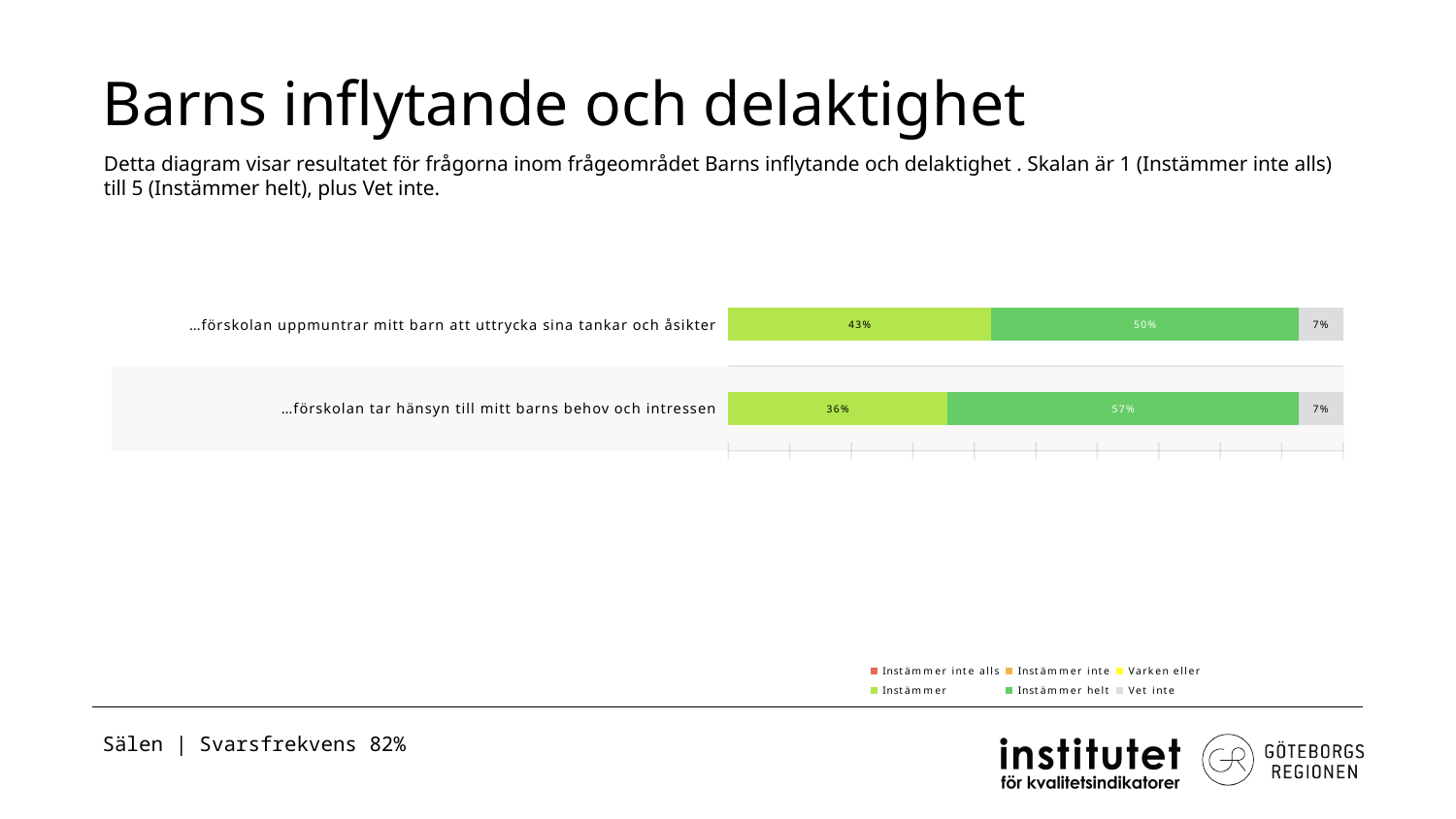
Which statement has the higher 'Instämmer helt' share? …förskolan tar hänsyn till mitt barns behov och intressen What is the 'Instämmer' value for '…förskolan uppmuntrar mitt barn att uttrycka sina tankar och åsikter'? 43% Is the 'Instämmer' value larger for '…förskolan uppmuntrar mitt barn att uttrycka sina tankar och åsikter' or for '…förskolan tar hänsyn till mitt barns behov och intressen'? …förskolan uppmuntrar mitt barn att uttrycka sina tankar och åsikter What kind of chart is shown on the slide? Stacked bar chart Which legend entry is shown in grey? Vet inte What is the difference between the 'Instämmer' values of the two statements? 7% What is the 'Instämmer helt' value for '…förskolan tar hänsyn till mitt barns behov och intressen'? 57% What is the 'Instämmer helt' value for '…förskolan uppmuntrar mitt barn att uttrycka sina tankar och åsikter'? 50% How many categories (statements) are plotted in the chart? 2 What is the 'Vet inte' value for '…förskolan tar hänsyn till mitt barns behov och intressen'? 7% How many series does the legend list? 6 What is the 'Instämmer' value for '…förskolan tar hänsyn till mitt barns behov och intressen'? 36%